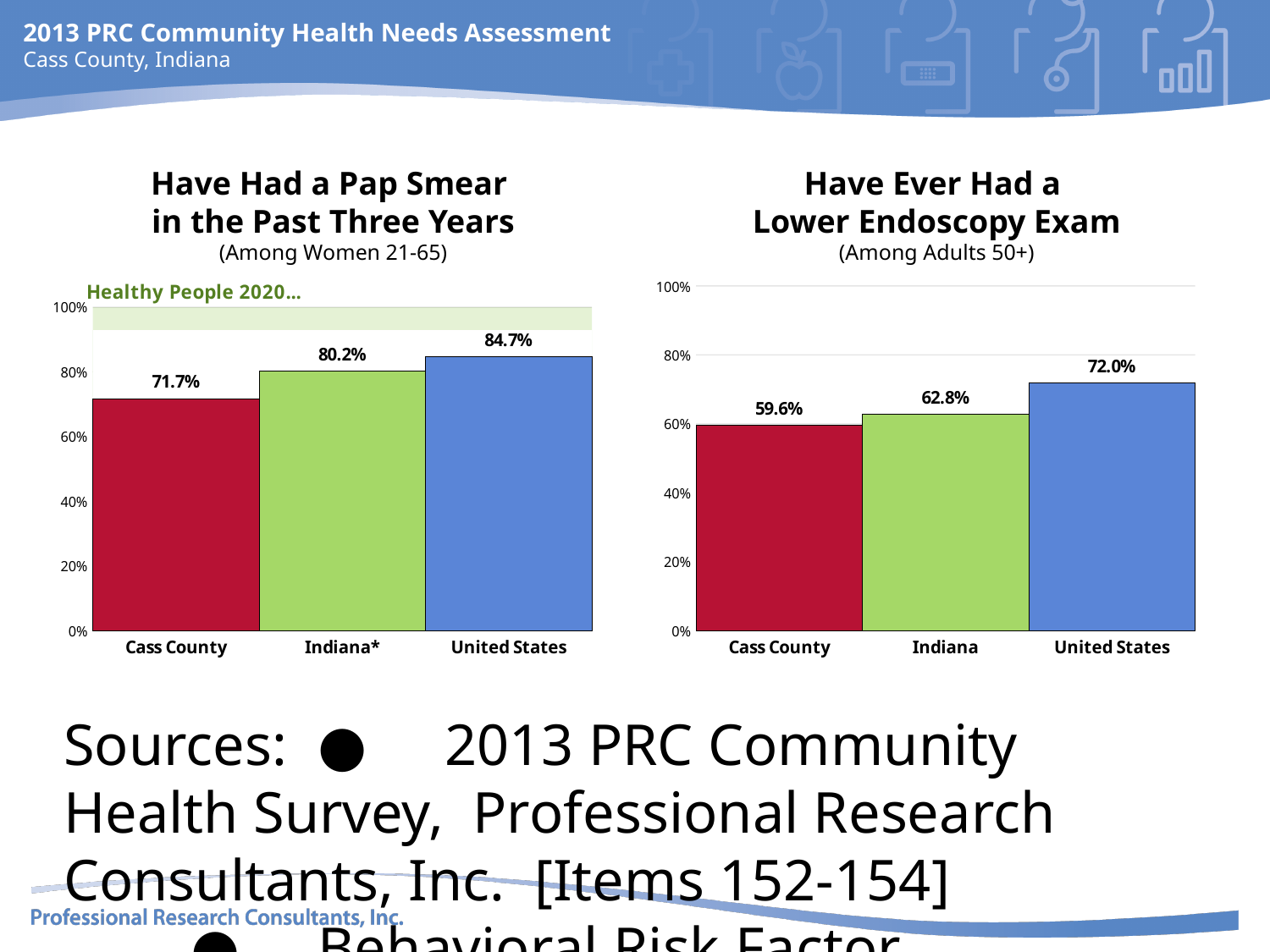
In the 'Have Had a Pap Smear in the Past Three Years' chart, is the value for Cass County greater or less than 80%? less In the 'Have Ever Had a Lower Endoscopy Exam' chart, what is the value for Indiana? 62.8% In the 'Have Ever Had a Lower Endoscopy Exam' chart, what is the difference between the Indiana and Cass County values? 3.2% In the 'Have Had a Pap Smear in the Past Three Years' chart, what is the value for Indiana*? 80.2% In the 'Have Had a Pap Smear in the Past Three Years' chart, which category has the highest value? United States How many categories are shown in the 'Have Ever Had a Lower Endoscopy Exam' chart? 3 In the 'Have Had a Pap Smear in the Past Three Years' chart, what is the difference between the United States and Cass County values? 13.0% In the 'Have Had a Pap Smear in the Past Three Years' chart, what is the value for Cass County? 71.7% In the 'Have Ever Had a Lower Endoscopy Exam' chart, which is larger, the value for Cass County or the value for the United States? United States In the 'Have Ever Had a Lower Endoscopy Exam' chart, which category has the lowest value? Cass County In the 'Have Ever Had a Lower Endoscopy Exam' chart, what is the value for the United States? 72.0% What kind of chart is the 'Have Had a Pap Smear in the Past Three Years' chart? Bar chart